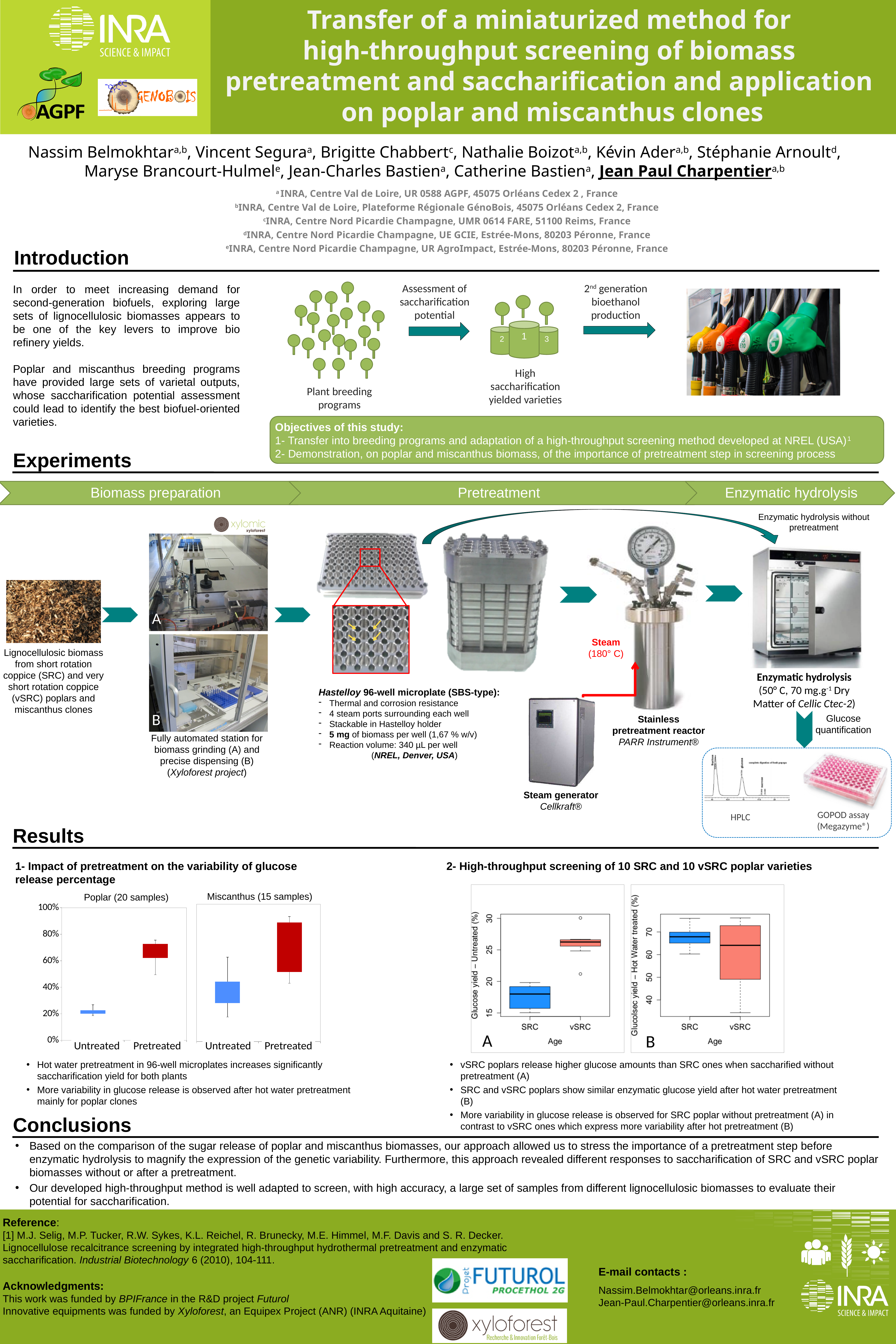
In chart A (Glucose yield – Untreated), is the median value for SRC greater or less than 20? less In chart A (Glucose yield – Untreated), which category has the higher glucose yield, SRC or vSRC? vSRC What is the y-axis label of chart B in the high-throughput screening results? Glucolsec yield – Hot Water treated (%) How many categories are shown on the x axis of the Poplar (20 samples) chart? 2 What kind of chart is the Poplar (20 samples) chart? Box plot In the Poplar (20 samples) chart, is the value for Pretreated greater or less than 40%? greater In the Miscanthus (15 samples) chart, which category has the higher glucose release percentage, Untreated or Pretreated? Pretreated In chart B (Glucose yield – Hot Water treated), is the median value for SRC greater or less than 60? greater In the Poplar (20 samples) chart, which category has the higher glucose release percentage, Untreated or Pretreated? Pretreated